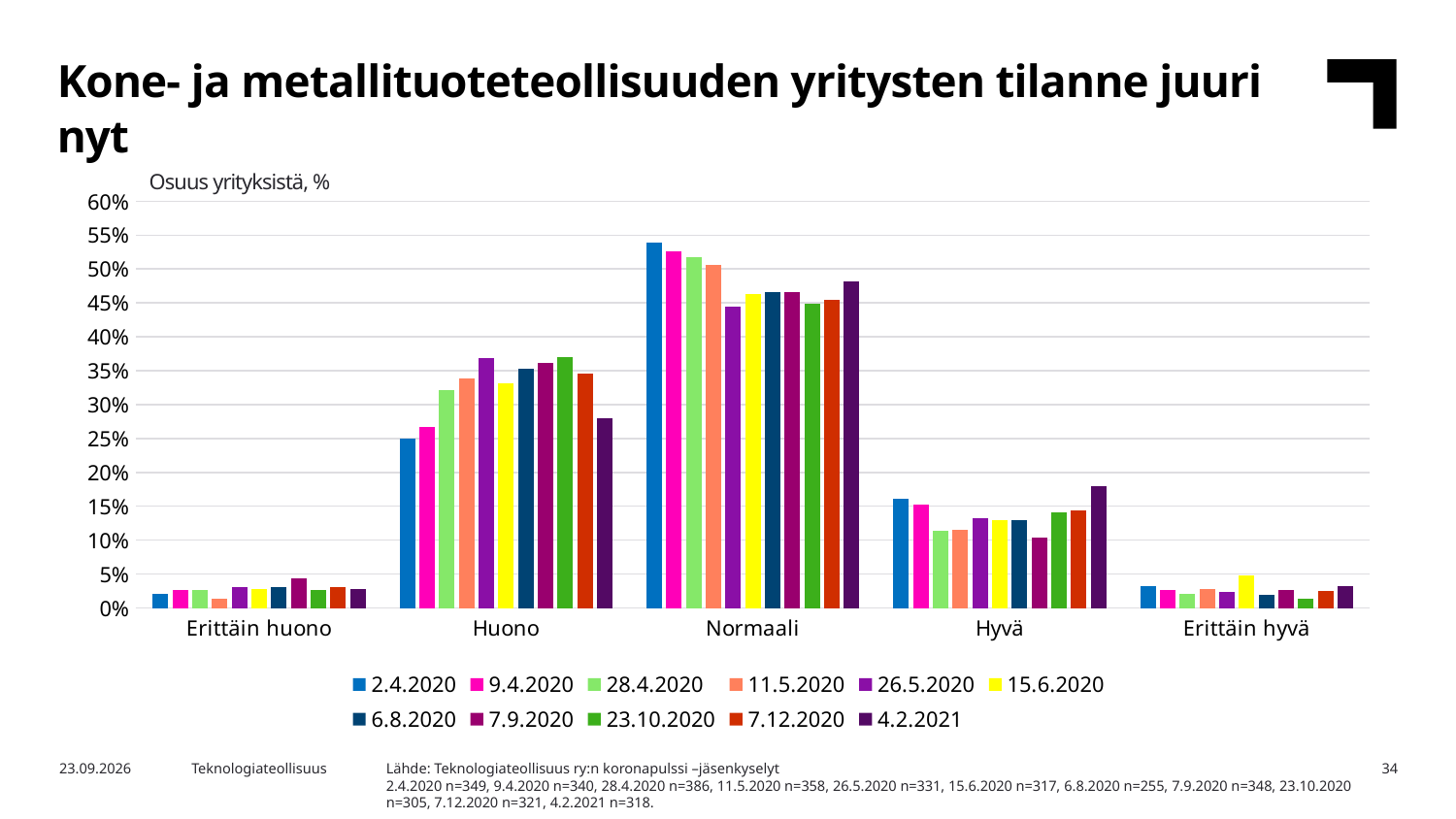
Is the value for Huono in the 4.2.2021 series greater or less than 30%? less Which category has the highest value for the 2.4.2020 series? Normaali Is the value for Normaali in the 2.4.2020 series greater or less than 50%? greater How many categories are shown on the x axis of the chart? 5 How many series does the chart legend list? 11 What type of chart is shown on the slide? bar chart Is the value for Huono in the 2.4.2020 series greater or less than 30%? less For the Huono category, which series has the larger value: 26.5.2020 or 4.2.2021? 26.5.2020 What is the label shown above the y axis of the chart? Osuus yrityksistä, % For the Normaali category, which series has the larger value: 2.4.2020 or 4.2.2021? 2.4.2020 For the Hyvä category, which series has the larger value: 2.4.2020 or 7.9.2020? 2.4.2020